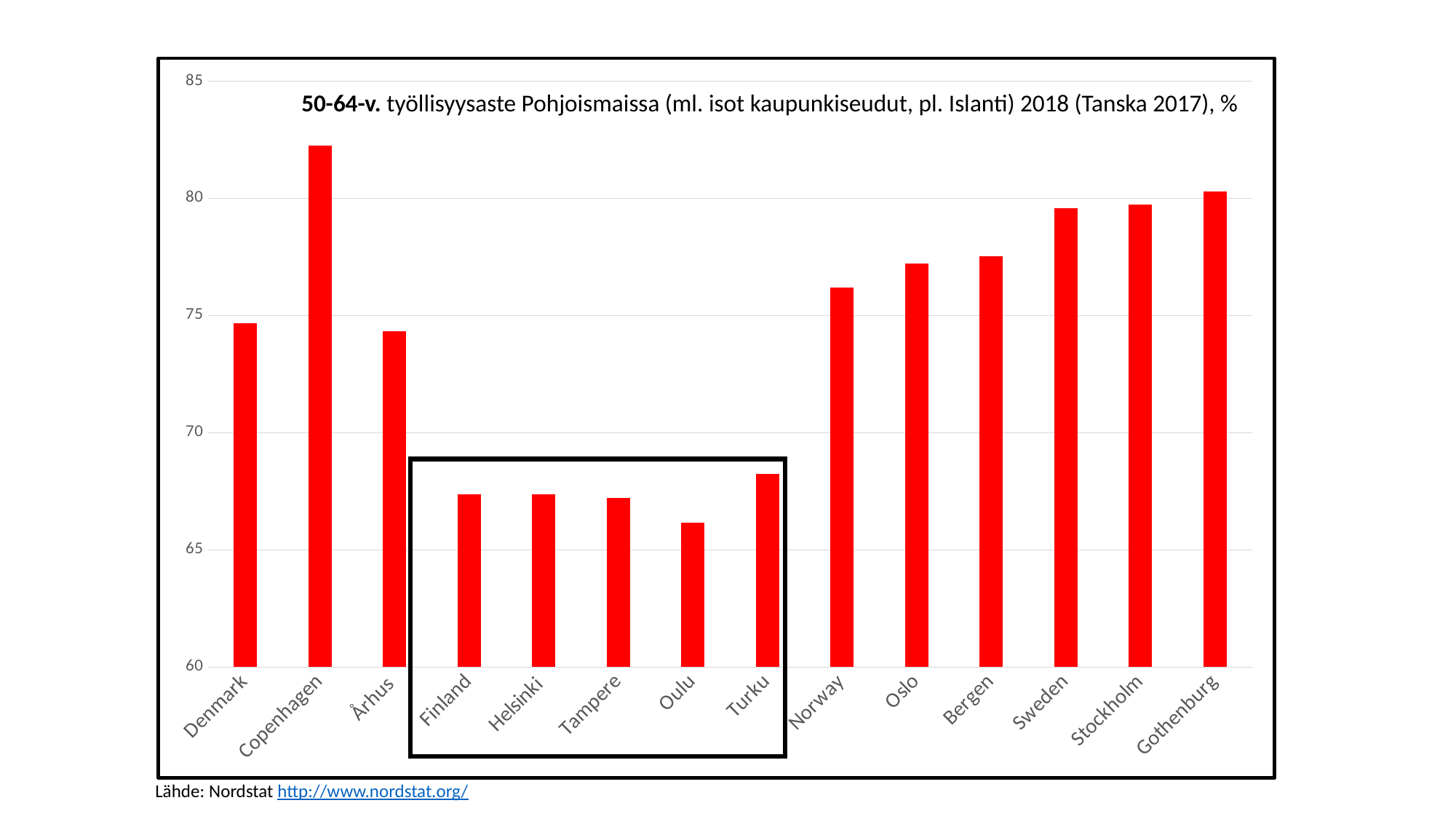
Which is larger, the value for Turku or the value for Oulu? Turku Is the value for Sweden greater or less than 80? less Which is larger, the value for Oslo or the value for Norway? Oslo Which category has the highest bar in the chart? Copenhagen Which is larger, the value for Copenhagen or the value for Gothenburg? Copenhagen What kind of chart is shown on the slide? bar chart Which category has the lowest bar in the chart? Oulu How many bars (categories) are plotted in the chart? 14 Is the value for Norway greater or less than 75? greater Is the value for Copenhagen greater or less than 80? greater What colour are the bars in the chart? red